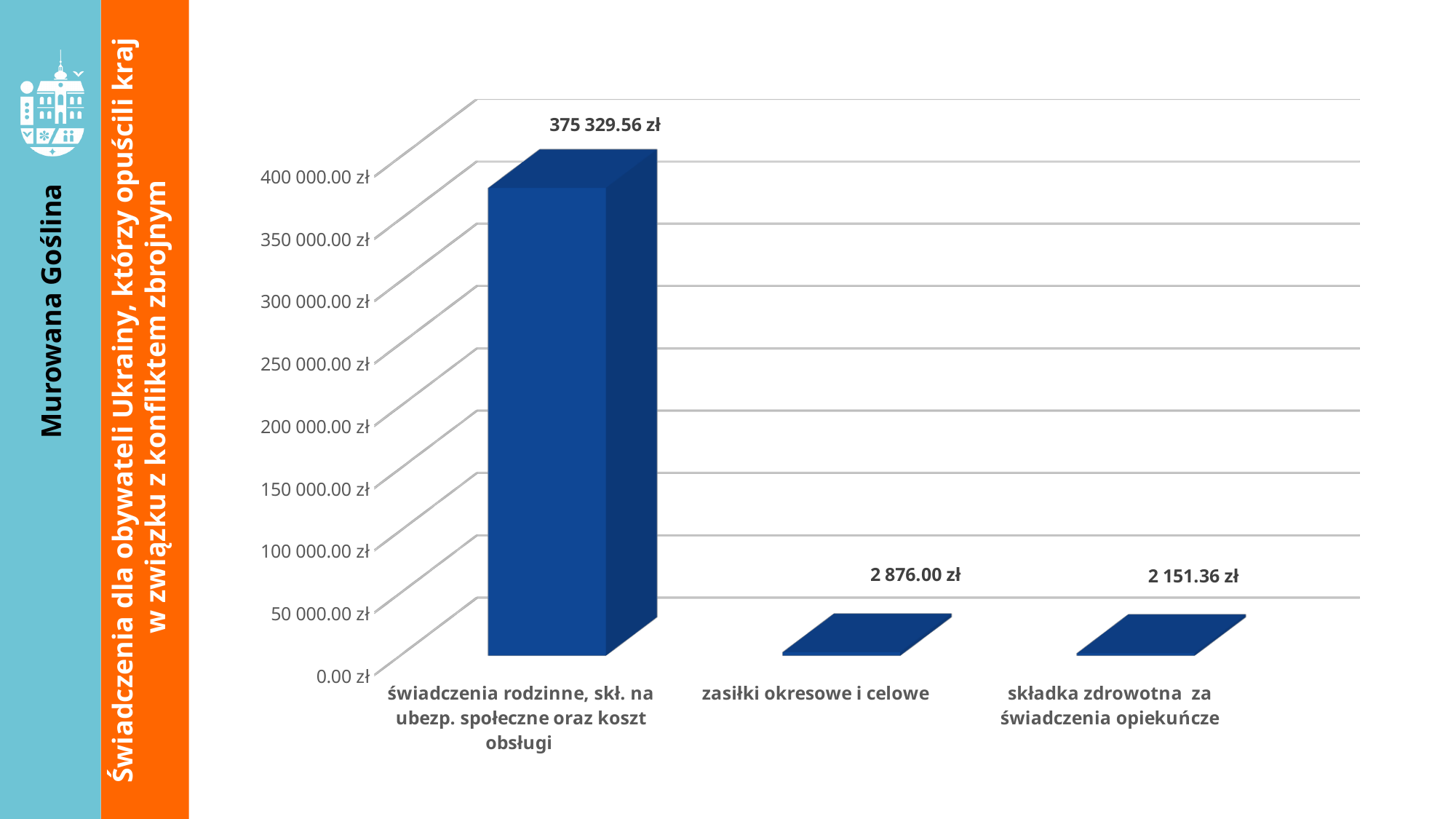
What is the difference between the value for "zasiłki okresowe i celowe" and the value for "składka zdrowotna za świadczenia opiekuńcze"? 724.64 zł What is the value for "świadczenia rodzinne, skł. na ubezp. społeczne oraz koszt obsługi"? 375 329.56 zł What is the value for "zasiłki okresowe i celowe"? 2 876.00 zł What is the difference between the value for "świadczenia rodzinne, skł. na ubezp. społeczne oraz koszt obsługi" and the value for "zasiłki okresowe i celowe"? 372 453.56 zł What kind of chart is shown on the slide? bar chart What is the value for "składka zdrowotna za świadczenia opiekuńcze"? 2 151.36 zł Which is larger: the value for "zasiłki okresowe i celowe" or the value for "składka zdrowotna za świadczenia opiekuńcze"? zasiłki okresowe i celowe How many categories are shown on the chart? 3 Is the value for "świadczenia rodzinne, skł. na ubezp. społeczne oraz koszt obsługi" greater or less than 350 000.00 zł? greater What is the title of the slide? Świadczenia dla obywateli Ukrainy, którzy opuścili kraj w związku z konfliktem zbrojnym Which category has the highest value? świadczenia rodzinne, skł. na ubezp. społeczne oraz koszt obsługi Which category has the lowest value? składka zdrowotna za świadczenia opiekuńcze